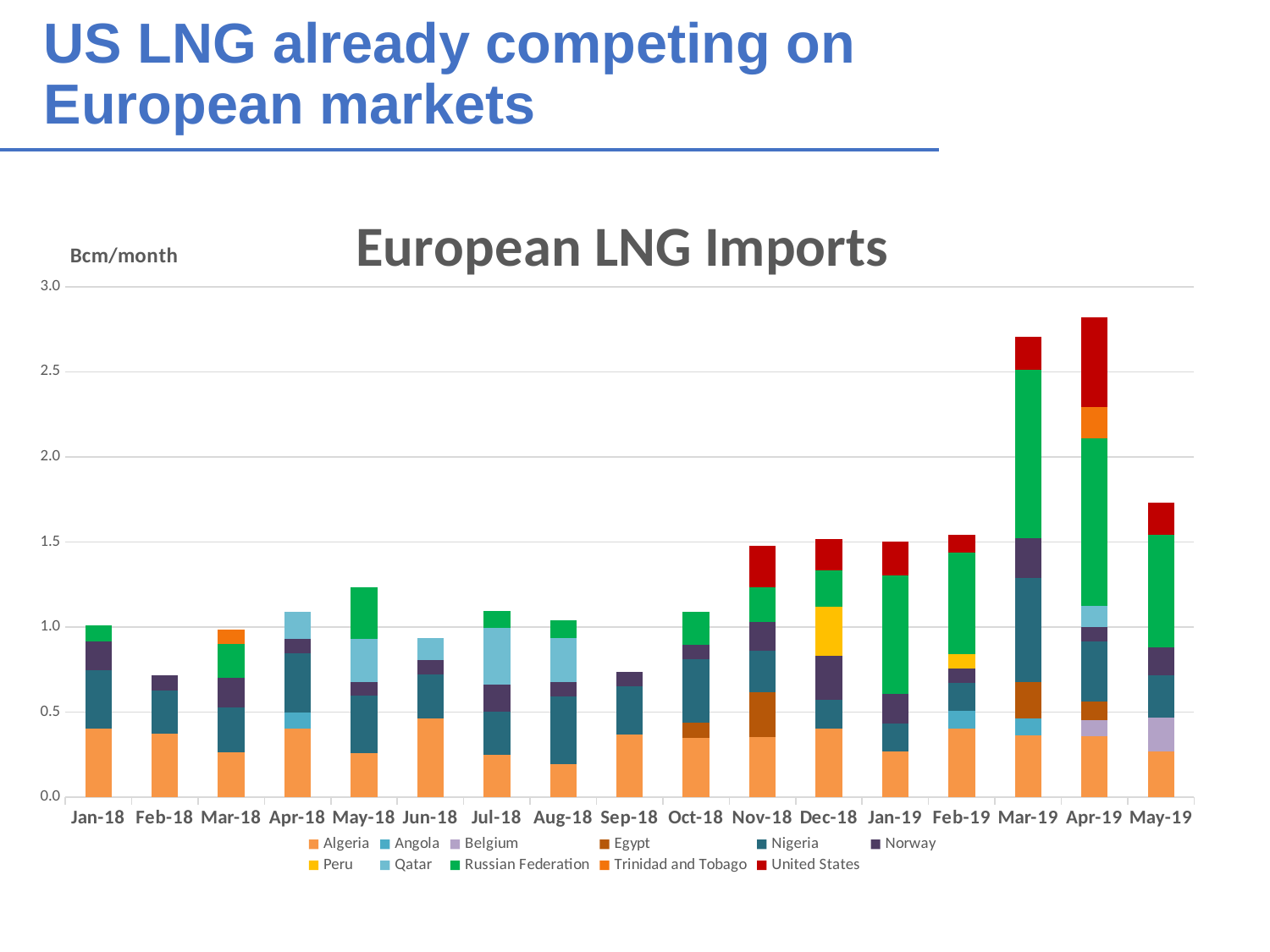
What is the title of the chart? European LNG Imports Do total LNG imports generally rise or fall from Sep-18 to Apr-19? Rise What kind of chart is shown on the slide? Stacked bar chart Which has the larger total, May-18 or Jun-18? May-18 What unit is shown for the y axis of the chart? Bcm/month Which month has the highest total LNG imports? Apr-19 Is the total value for May-19 greater or less than 1.5? greater Is the total value for Feb-18 greater or less than 1.0? less How many months are shown along the x axis of the chart? 17 How many series does the legend list? 11 Which has the larger total, Mar-19 or Apr-19? Apr-19 Is the total value for Apr-19 greater or less than 2.5? greater